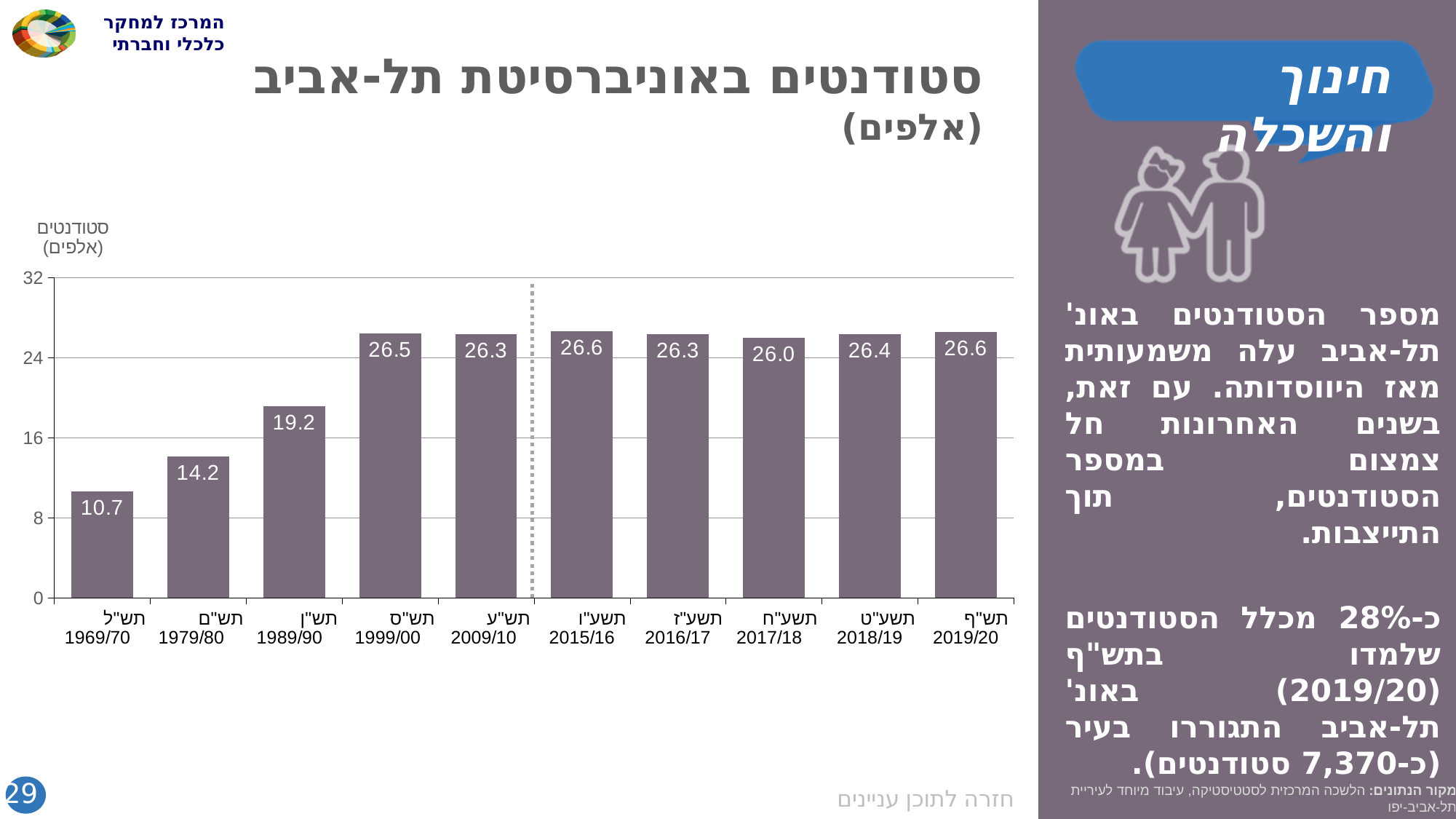
What is the difference between the values for 1999/00 and 1989/90? 7.3 How many years (bars) are shown in the chart? 10 Which year has the lowest number of students? 1969/70 (תש"ל) Which is larger, the value for 1999/00 or the value for 1989/90? 1999/00 What is the difference between the values for 1979/80 and 1969/70? 3.5 Is the value for 1979/80 greater or less than 16? less What kind of chart is shown on the slide? bar chart What is the value for 1989/90 (תש"ן)? 19.2 What is the value for 2019/20 (תש"ף)? 26.6 What is the value for 2017/18 (תשע"ח)? 26.0 What is the value for 1969/70 (תש"ל)? 10.7 Do the values rise or fall from 1969/70 to 1999/00? rise